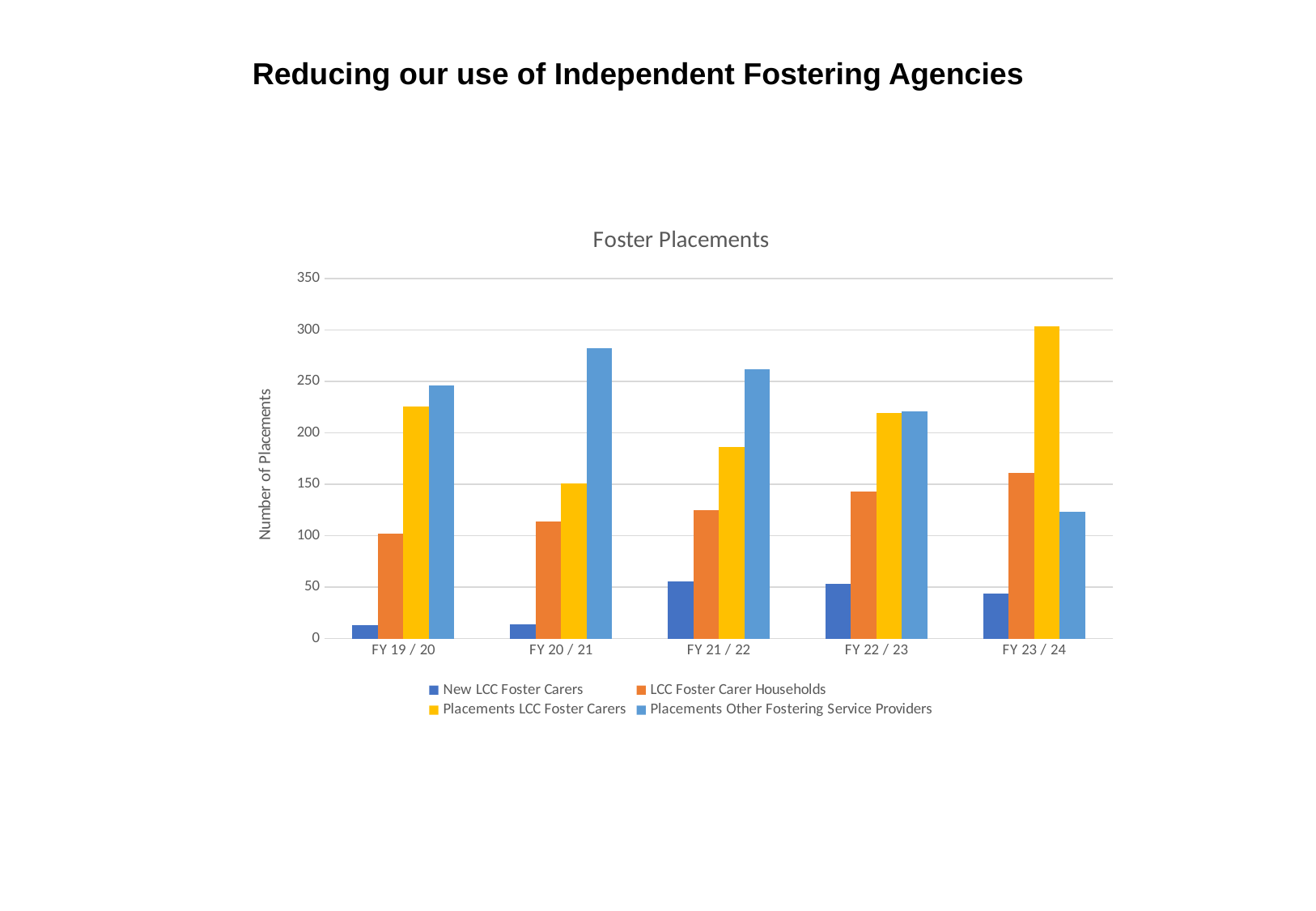
Do the values for LCC Foster Carer Households rise or fall from FY 19 / 20 to FY 23 / 24? rise In which financial year is the value for Placements Other Fostering Service Providers lowest? FY 23 / 24 Is the value for New LCC Foster Carers in FY 19 / 20 greater or less than 50? less How many series does the legend of the Foster Placements chart list? 4 In which financial year is the value for Placements Other Fostering Service Providers highest? FY 20 / 21 Is the value for Placements Other Fostering Service Providers in FY 23 / 24 greater or less than 150? less In FY 23 / 24, which is larger: Placements LCC Foster Carers or Placements Other Fostering Service Providers? Placements LCC Foster Carers How many financial years are shown on the x axis of the Foster Placements chart? 5 Is the value for Placements LCC Foster Carers in FY 23 / 24 greater or less than 250? greater What is the label on the vertical axis of the chart? Number of Placements What kind of chart is shown on the slide? bar chart In FY 20 / 21, which is larger: Placements LCC Foster Carers or Placements Other Fostering Service Providers? Placements Other Fostering Service Providers